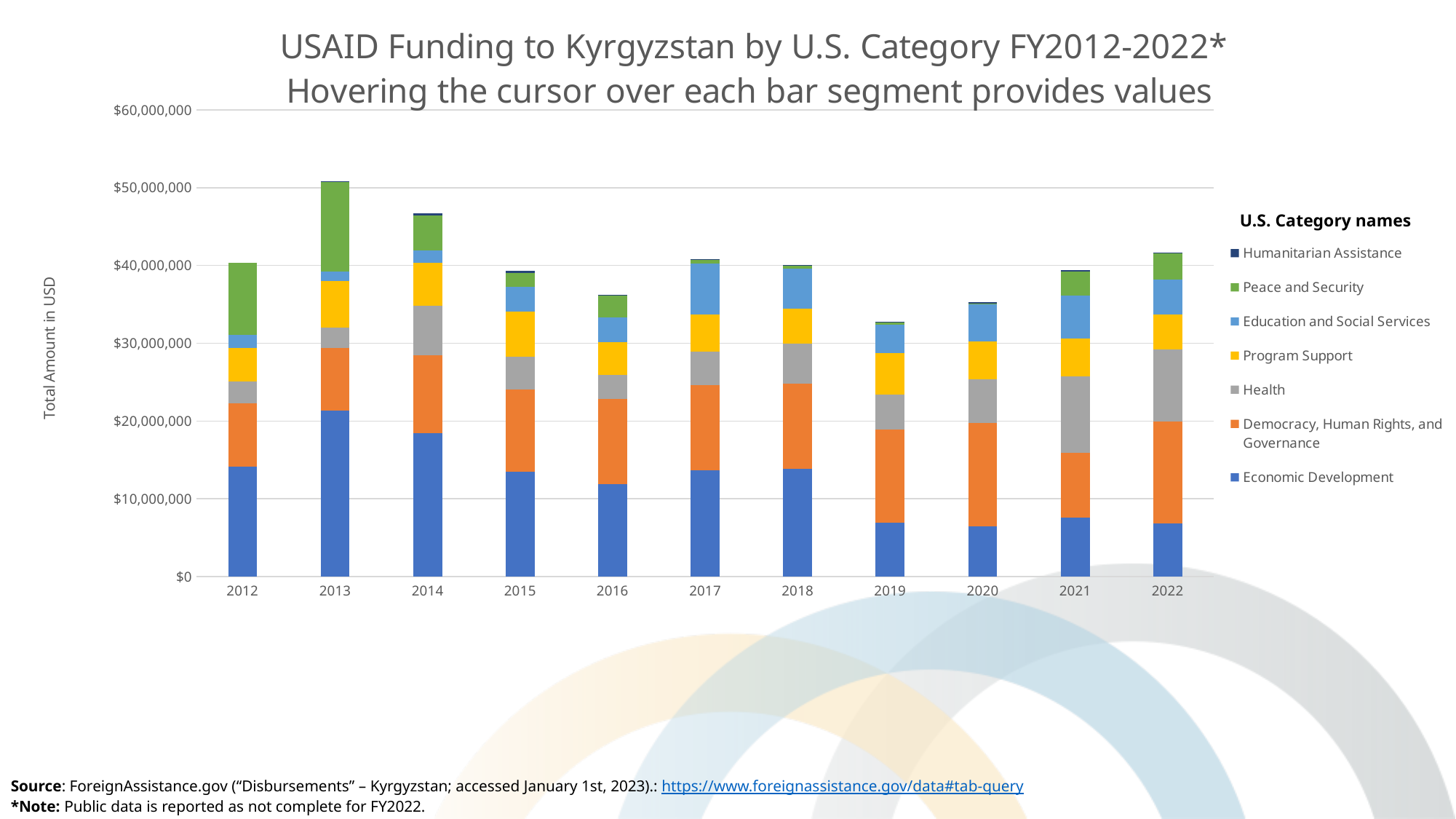
How many fiscal years are shown on the x axis of the chart? 11 Which year has the lowest total USAID funding to Kyrgyzstan? 2019 Is the total funding for 2013 greater or less than $40,000,000? greater Which year has a larger total funding, 2013 or 2012? 2013 Which year has the highest total USAID funding to Kyrgyzstan? 2013 Is the total funding for 2019 greater or less than $40,000,000? less What kind of chart is shown on the slide? Stacked bar chart How many U.S. category names does the legend list? 7 Is the total funding for 2016 greater or less than $40,000,000? less What is the label of the y axis of the chart? Total Amount in USD Which category is shown at the bottom of each stacked bar? Economic Development